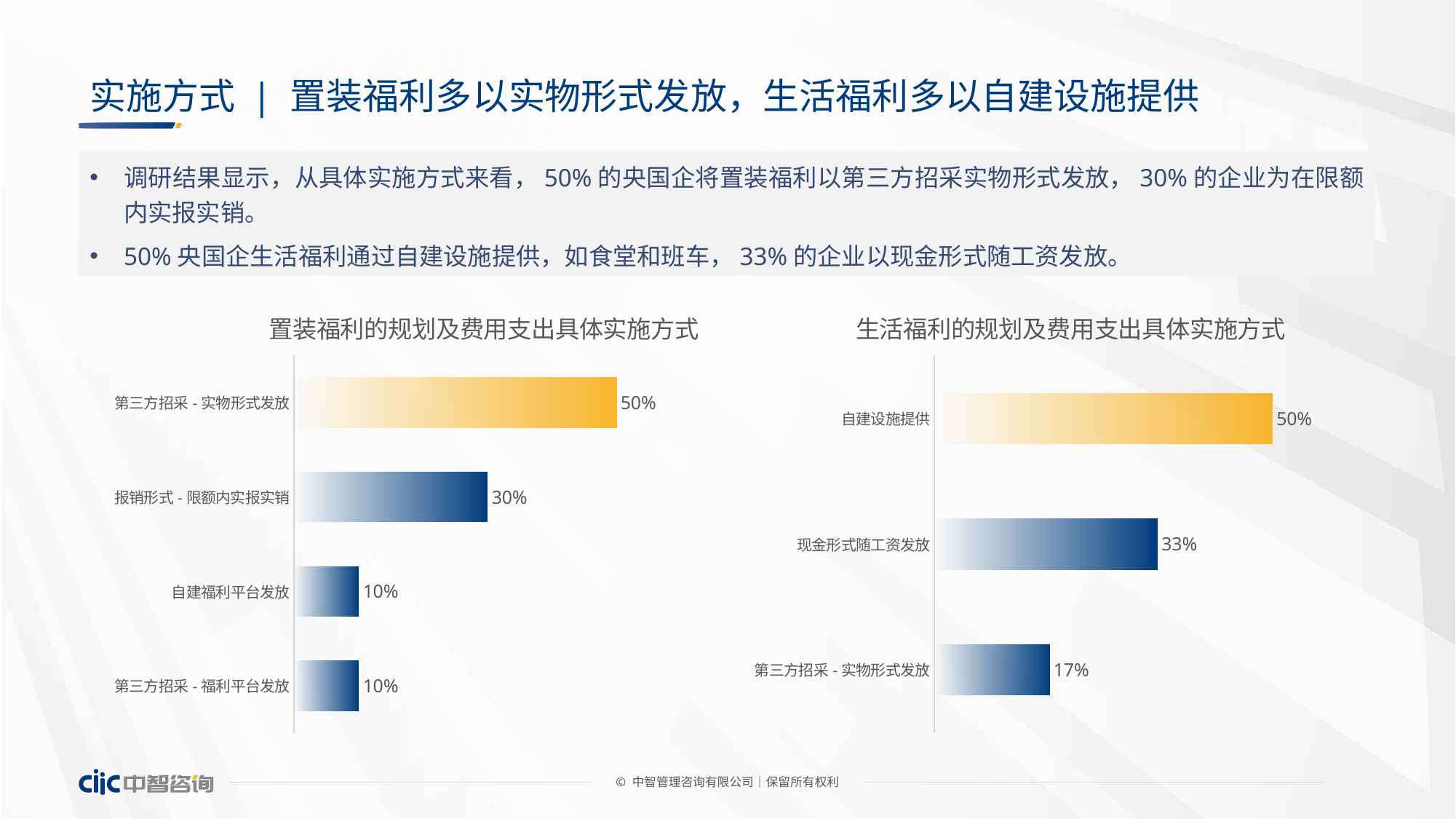
In the right chart (生活福利的规划及费用支出具体实施方式), what is the value for 现金形式随工资发放? 33% How many categories are shown in the right chart (生活福利的规划及费用支出具体实施方式)? 3 In the right chart (生活福利的规划及费用支出具体实施方式), which is larger: 现金形式随工资发放 or 第三方招采 - 实物形式发放? 现金形式随工资发放 In the left chart (置装福利的规划及费用支出具体实施方式), what is the value for 报销形式 - 限额内实报实销? 30% In the left chart (置装福利的规划及费用支出具体实施方式), what is the value for 第三方招采 - 实物形式发放? 50% In the right chart (生活福利的规划及费用支出具体实施方式), which category has the lowest value? 第三方招采 - 实物形式发放 In the right chart (生活福利的规划及费用支出具体实施方式), what is the value for 第三方招采 - 实物形式发放? 17% In the left chart (置装福利的规划及费用支出具体实施方式), which category has the highest value? 第三方招采 - 实物形式发放 In the left chart (置装福利的规划及费用支出具体实施方式), what is the difference between 第三方招采 - 实物形式发放 and 报销形式 - 限额内实报实销? 20% What type of chart is the right chart (生活福利的规划及费用支出具体实施方式)? Bar chart In the right chart (生活福利的规划及费用支出具体实施方式), what is the difference between 自建设施提供 and 现金形式随工资发放? 17% How many categories are shown in the left chart (置装福利的规划及费用支出具体实施方式)? 4